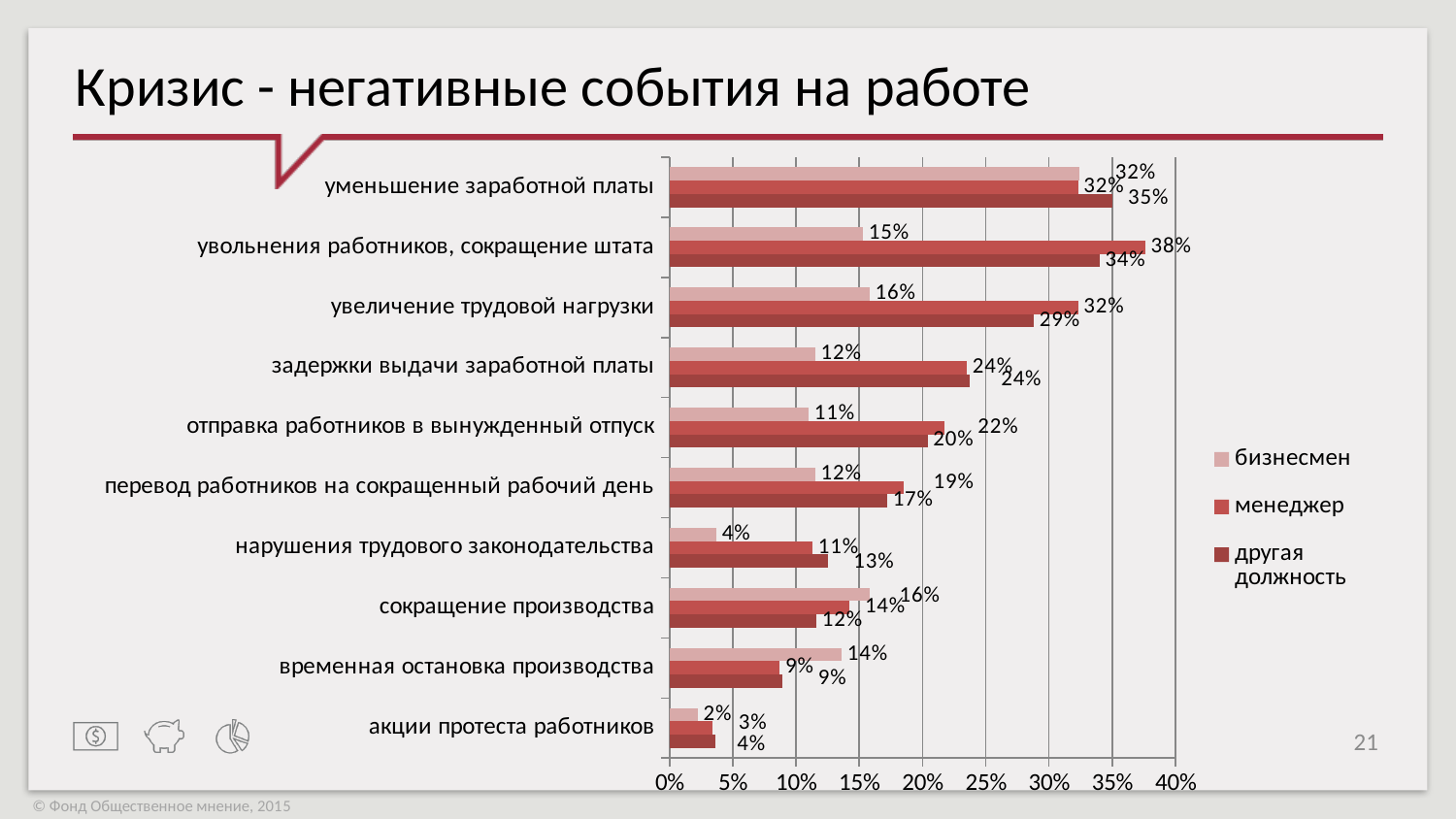
What kind of chart is shown on the slide? bar chart What is the value for "бизнесмен" in the category "уменьшение заработной платы"? 32% For "сокращение производства", which series has the larger value: "бизнесмен" or "другая должность"? бизнесмен What is the title of the slide? Кризис - негативные события на работе What is the difference between the "менеджер" and "бизнесмен" values for "увольнения работников, сокращение штата"? 23% What is the value for "менеджер" in the category "увольнения работников, сокращение штата"? 38% Which category has the highest value for the "менеджер" series? увольнения работников, сокращение штата How many categories are shown on the chart? 10 Which category has the lowest value for the "бизнесмен" series? акции протеста работников How many series does the legend list? 3 Is the "другая должность" value for "увеличение трудовой нагрузки" greater or less than 25%? greater What is the value for "другая должность" in the category "нарушения трудового законодательства"? 13%